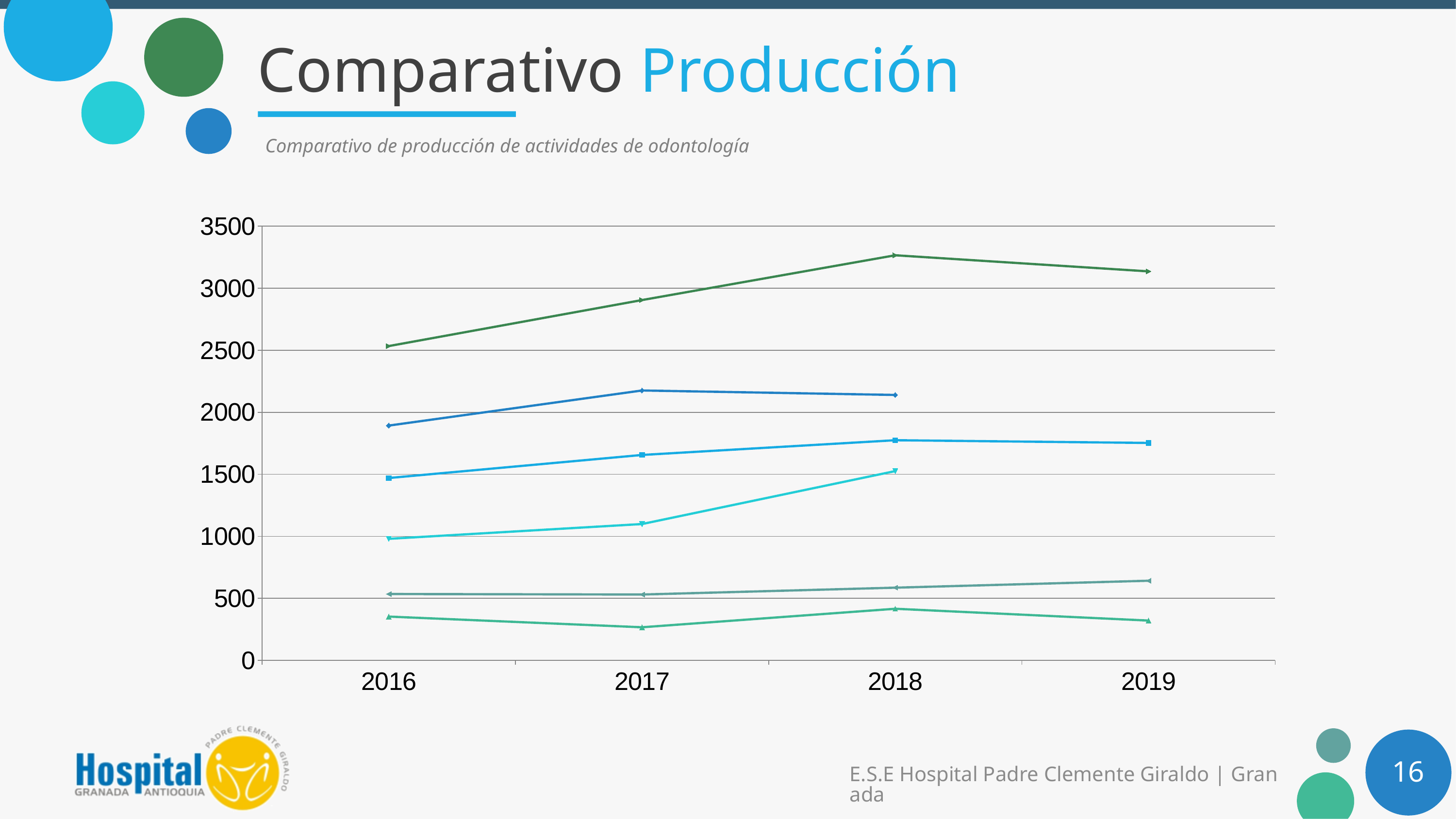
In 2018, which line has the larger value: the dark green line or the dark blue line? dark green line What kind of chart is shown on the slide? line chart In which year does the dark green (topmost) line reach its highest value? 2018 Is the value of the light blue line in 2016 greater or less than 1000? greater Is the value of the dark green (topmost) line in 2018 greater or less than 3000? greater What is the highest value shown on the y axis of the chart? 3500 In which year does the lowest (light green) line reach its lowest value? 2017 Is the value of the lowest (light green) line in 2017 greater or less than 500? less How many lines are plotted on the chart? 6 Does the dark green (topmost) line rise or fall from 2016 to 2018? rise How many years are shown on the x axis of the chart? 4